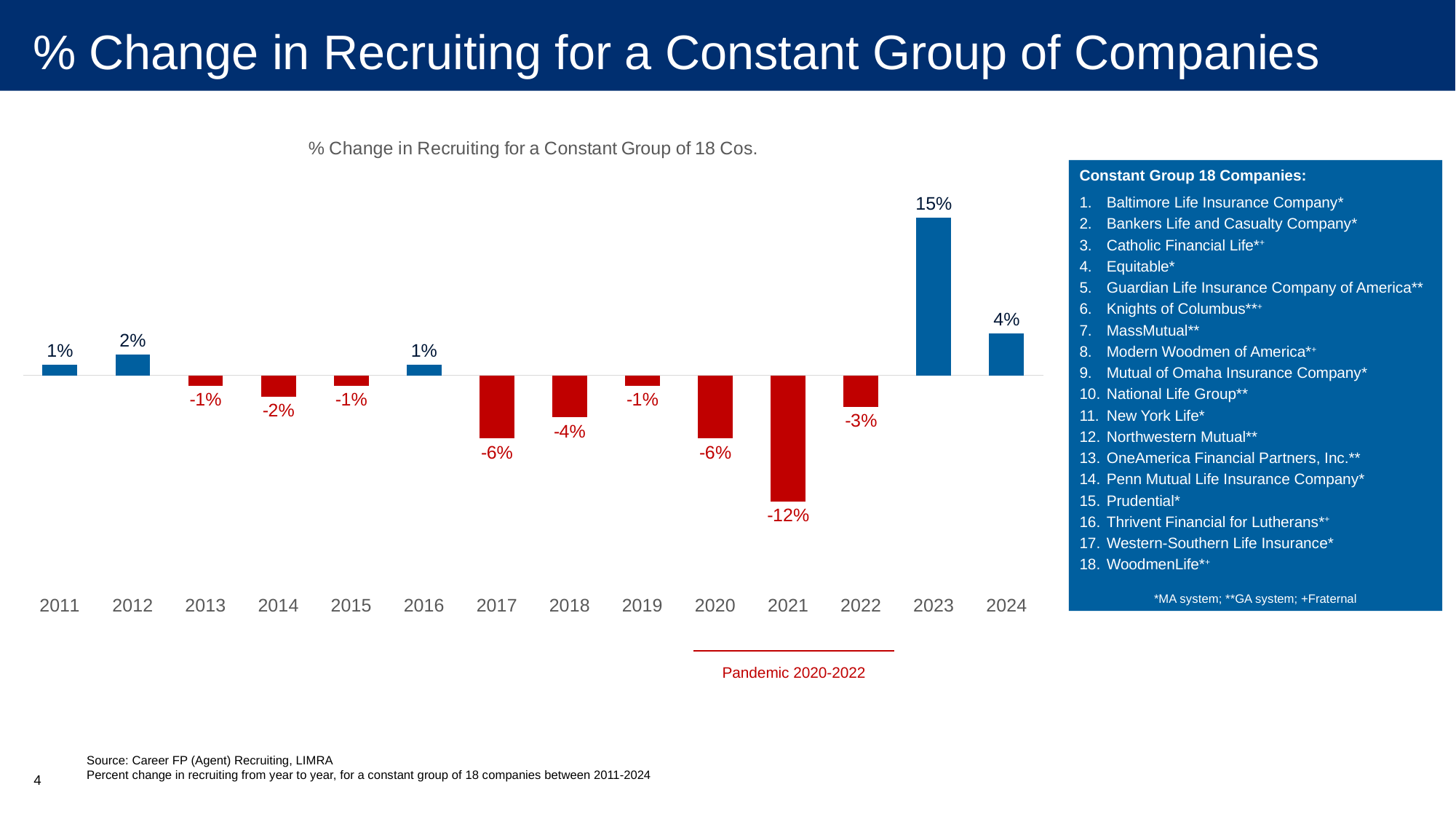
What is the % change in recruiting for 2021? -12% Which year has the highest % change in recruiting? 2023 What kind of chart is shown on the slide? Bar chart What is the % change in recruiting for 2018? -4% Which year has a larger % change in recruiting, 2017 or 2022? 2022 Which years are labelled as the pandemic period below the chart? 2020-2022 What is the % change in recruiting for 2024? 4% What is the % change in recruiting for 2023? 15% Which year has the lowest % change in recruiting? 2021 What is the title of the chart? % Change in Recruiting for a Constant Group of 18 Cos. What is the difference between the % change in 2023 and the % change in 2024? 11 percentage points How many years are shown on the x axis of the chart? 14